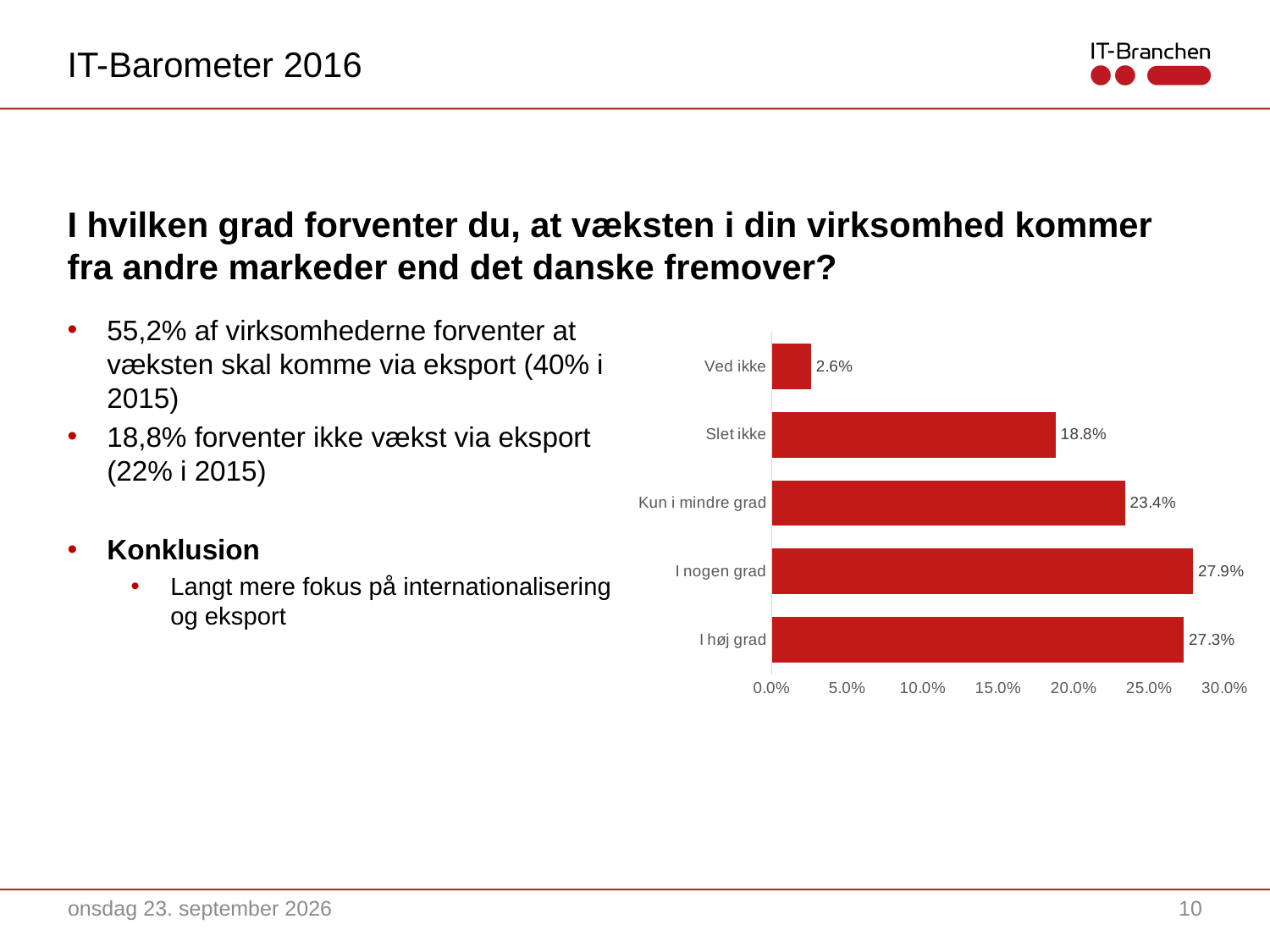
Which category has the highest value? I nogen grad What is the value for "I høj grad"? 27.3% What is the value for "Ved ikke"? 2.6% Is the value for "I høj grad" greater or less than 25.0%? greater Which category has the lowest value? Ved ikke What kind of chart is shown on the slide? bar chart Which is larger, the value for "Kun i mindre grad" or the value for "Slet ikke"? Kun i mindre grad What is the value for "Slet ikke"? 18.8% How many categories are shown in the chart? 5 What is the value for "Kun i mindre grad"? 23.4% What is the difference between the values for "Kun i mindre grad" and "Slet ikke"? 4.6% What is the highest value shown on the x axis of the chart? 30.0%